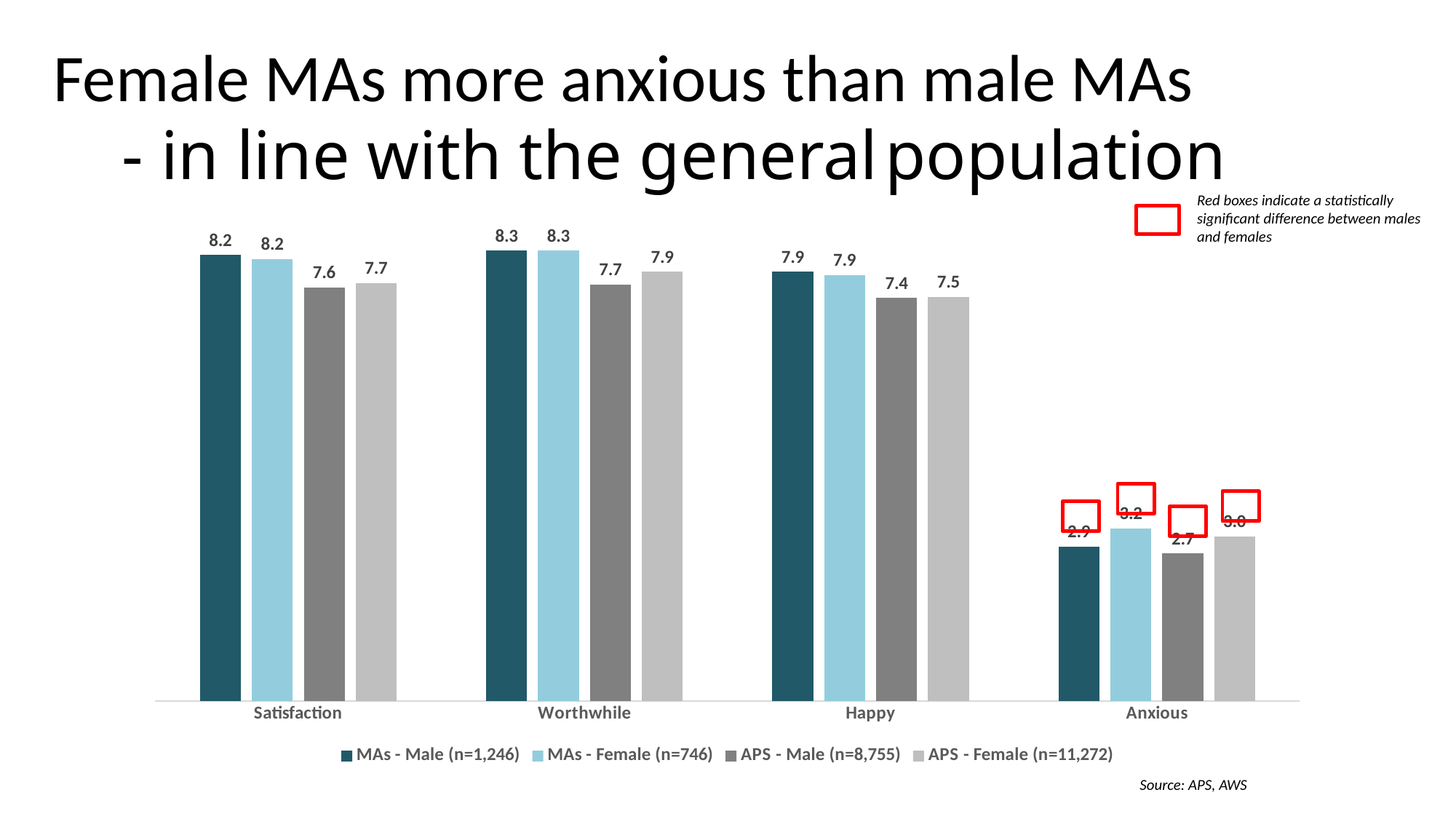
Which category has the lowest values across all series? Anxious What kind of chart is shown on the slide? bar chart What is the value for APS - Male (n=8,755) in the Worthwhile category? 7.7 According to the note on the slide, what do the red boxes indicate? A statistically significant difference between males and females What is the difference between the MAs - Male and APS - Male values in the Satisfaction category? 0.6 Which is larger in the Happy category: the value for MAs - Male (n=1,246) or the value for APS - Male (n=8,755)? MAs - Male (n=1,246) What is the difference between the APS - Female and APS - Male values in the Worthwhile category? 0.2 What is the value for MAs - Female (n=746) in the Worthwhile category? 8.3 How many series does the chart's legend list? 4 What is the value for MAs - Male (n=1,246) in the Satisfaction category? 8.2 How many categories are shown on the x axis of the chart? 4 What is the value for APS - Female (n=11,272) in the Happy category? 7.5